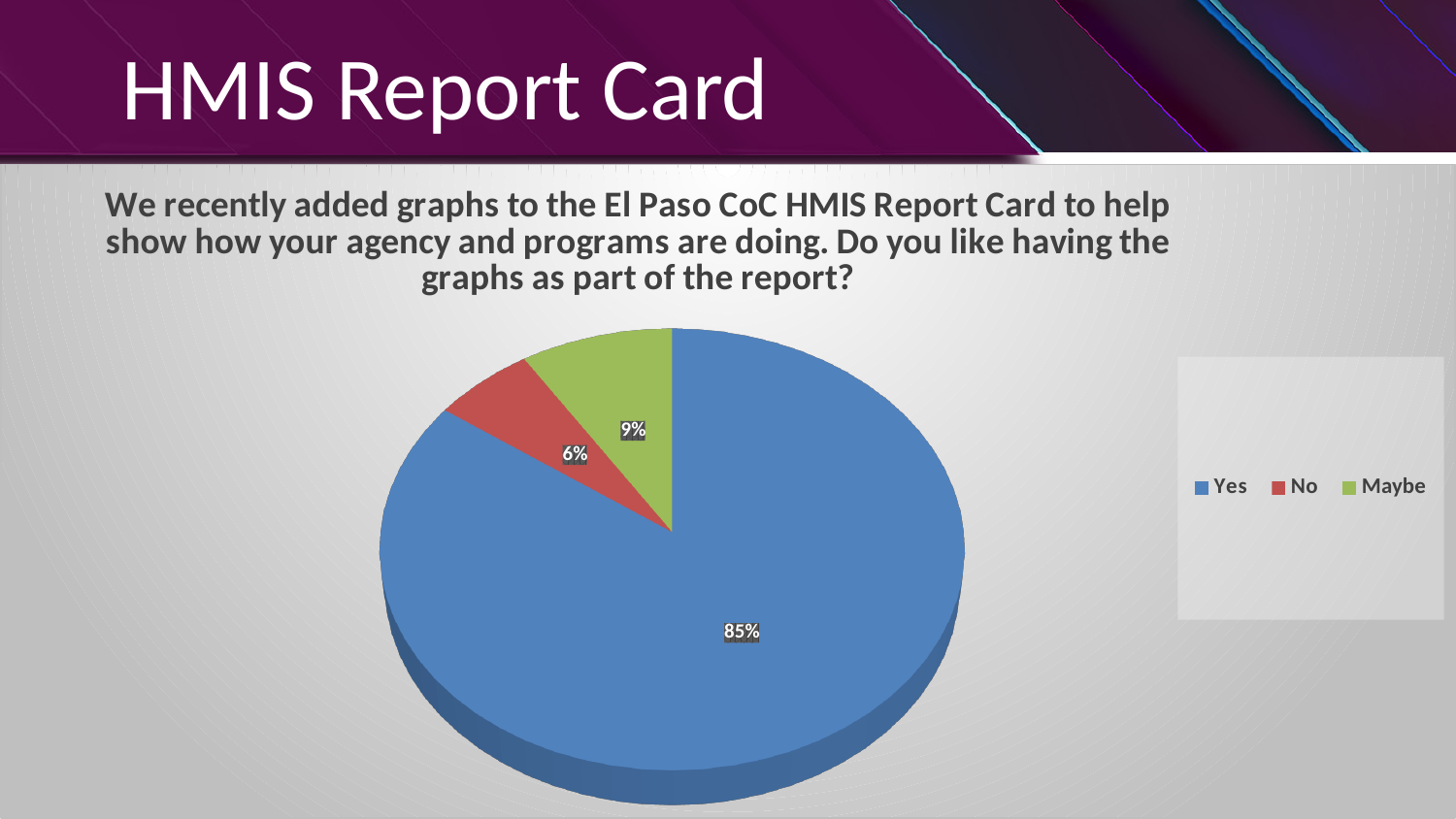
How many entries does the legend list? 3 What kind of chart is shown on the slide? pie chart What is the difference in percentage points between the Yes and Maybe slices? 76 Which response has the largest share of the pie? Yes Which is larger, the Maybe slice or the No slice? Maybe Which response has the smallest share of the pie? No What percentage of respondents answered No? 6% What colour is the Maybe slice? green What percentage of respondents answered Yes? 85% How many slices does the pie chart have? 3 What percentage of respondents answered Maybe? 9% What colour is the Yes slice? blue